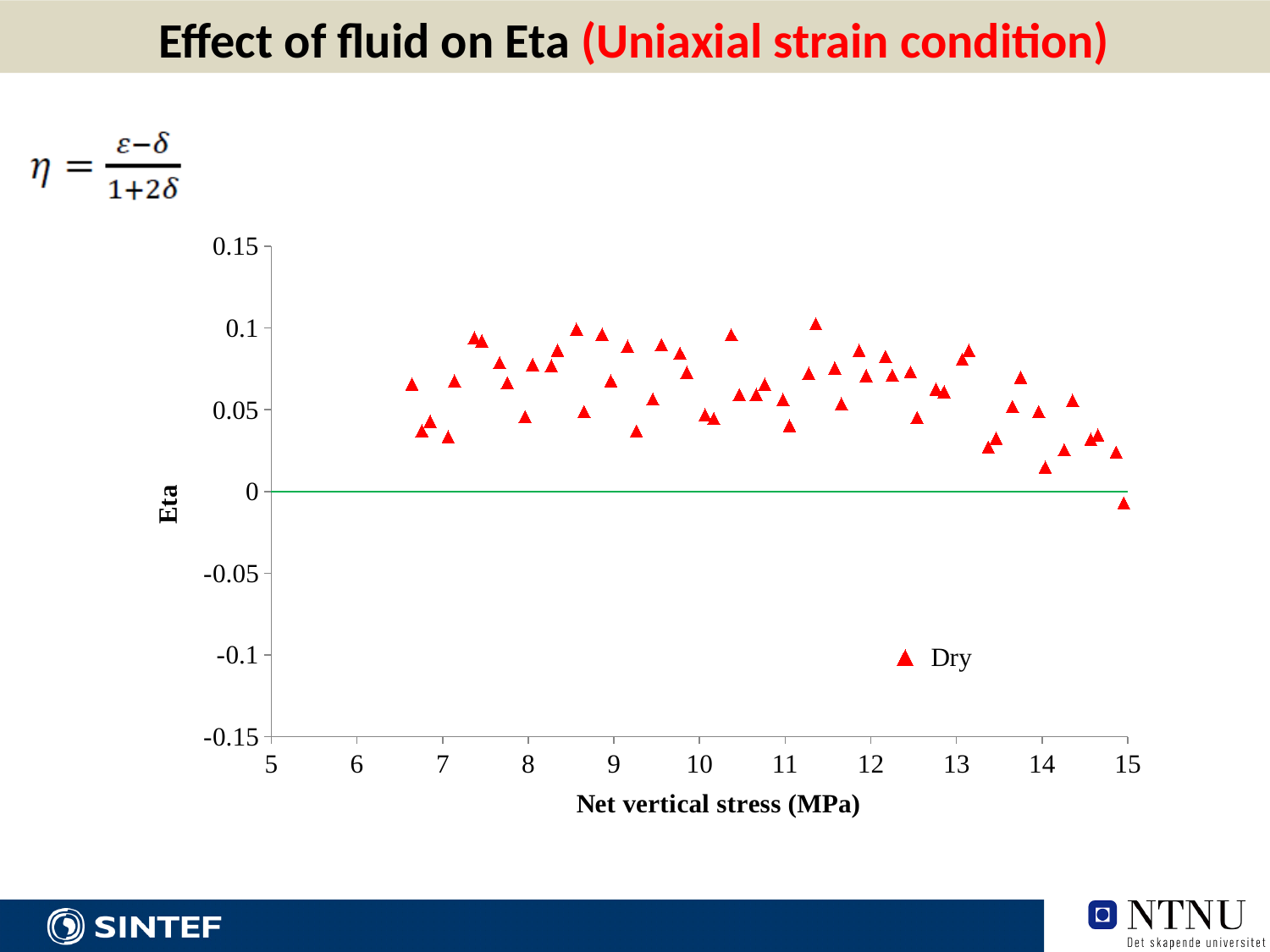
What kind of chart is shown on the slide? Scatter chart What is the name of the series shown in the legend? Dry Is the Dry value at a net vertical stress of about 11.3 MPa greater or less than 0.05? greater How many series does the legend list? 1 What is the maximum value shown on the Eta axis? 0.15 Is the Dry value at about 8.6 MPa larger or smaller than the Dry value at about 14.9 MPa? larger Is the Dry value at a net vertical stress of about 14 MPa greater or less than 0.05? less Do the Dry values generally rise or fall as net vertical stress increases from 13 MPa to 15 MPa? fall What is the label of the x axis? Net vertical stress (MPa) Is the Dry value at a net vertical stress of about 15 MPa greater or less than 0? less